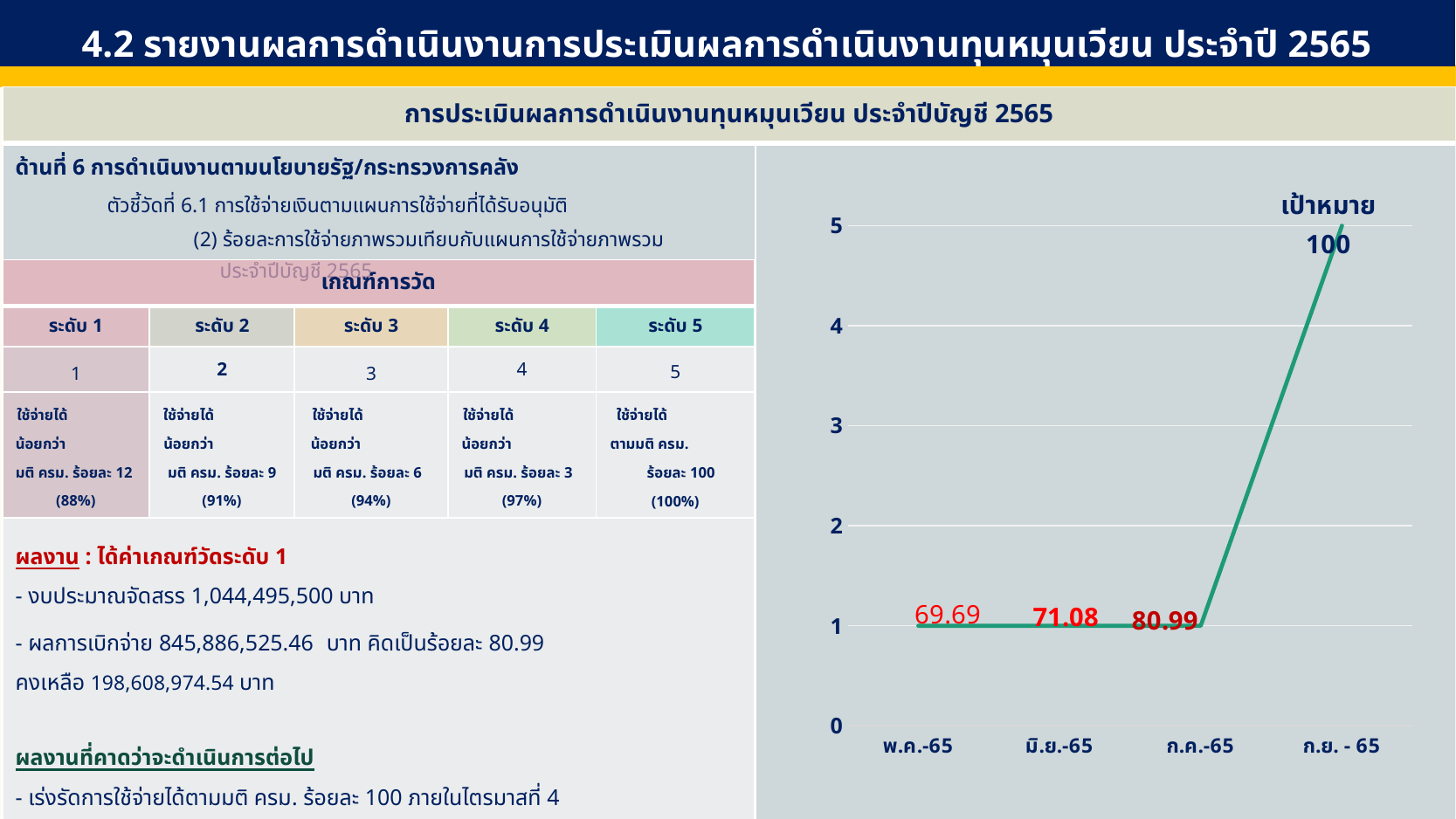
Which has the larger data label in the line chart, มิ.ย.-65 or ก.ค.-65? ก.ค.-65 Do the values on the line chart rise or fall from ก.ค.-65 to ก.ย. - 65? rise How many points are plotted along the x axis of the line chart? 4 Which x-axis category has the lowest data label on the line chart? พ.ค.-65 Is the plotted level for ก.ค.-65 on the line chart greater or less than 2? less What is the difference between the data labels for ก.ค.-65 and พ.ค.-65 in the line chart? 11.30 What data label is shown for มิ.ย.-65 in the line chart? 71.08 What data label is shown for พ.ค.-65 in the line chart? 69.69 What value is shown for the เป้าหมาย point at ก.ย. - 65 in the line chart? 100 What kind of chart is shown on the right side of the slide? line chart Which x-axis category has the highest point on the line chart? ก.ย. - 65 What data label is shown for ก.ค.-65 in the line chart? 80.99